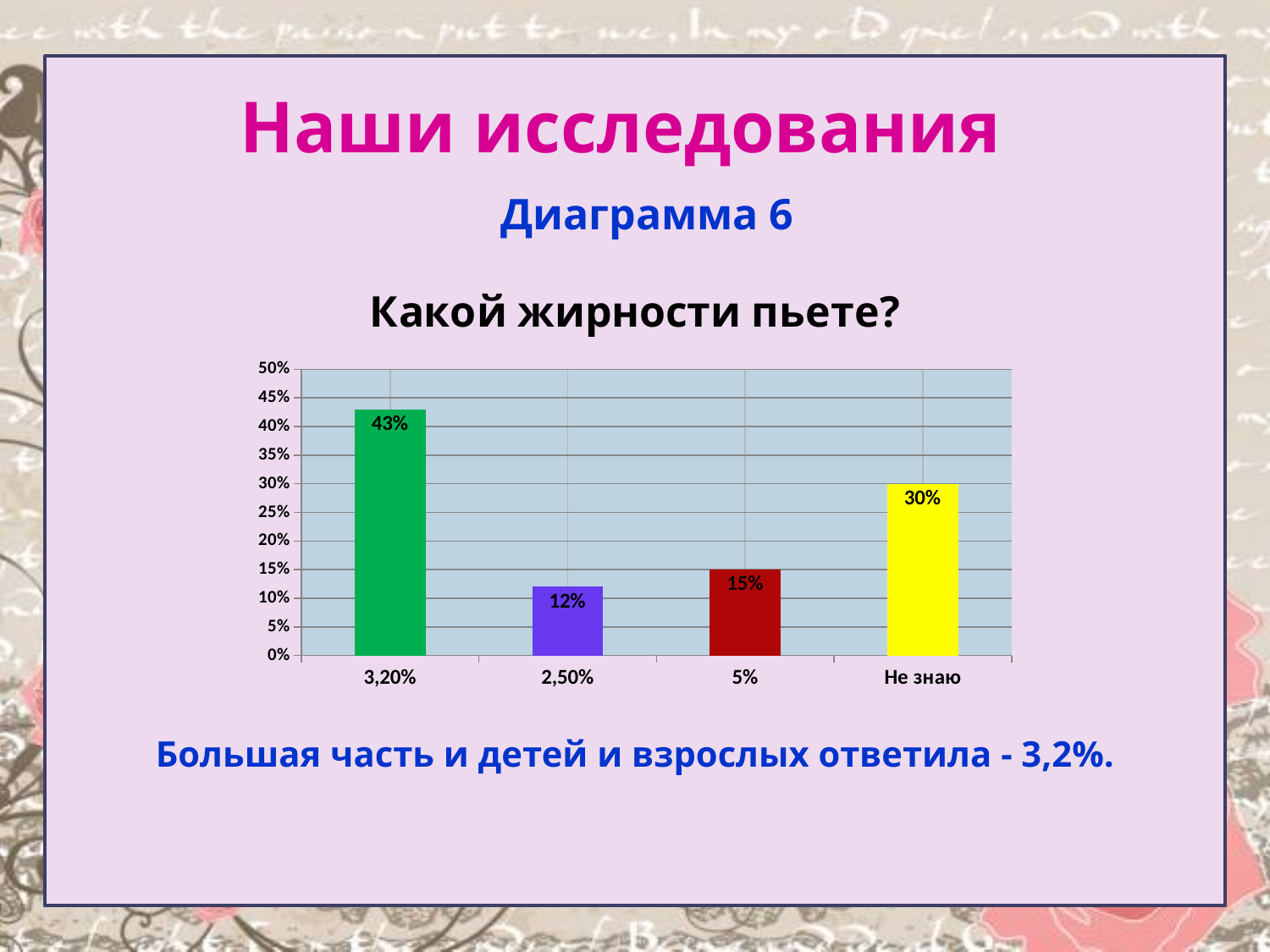
What value is shown for the category "2,50%"? 12% Which category has the lowest value? 2,50% What is the title of the chart? Какой жирности пьете? What is the difference between the values for "3,20%" and "Не знаю"? 13% Is the value for "Не знаю" greater or less than 25%? greater How many categories are shown on the x axis? 4 What value is shown for the category "Не знаю"? 30% What colour is the bar for the category "5%"? dark red What value is shown for the category "3,20%"? 43% Which category has the highest value? 3,20% What kind of chart is shown on the slide? bar chart Which is larger: the value for "5%" or the value for "2,50%"? 5%